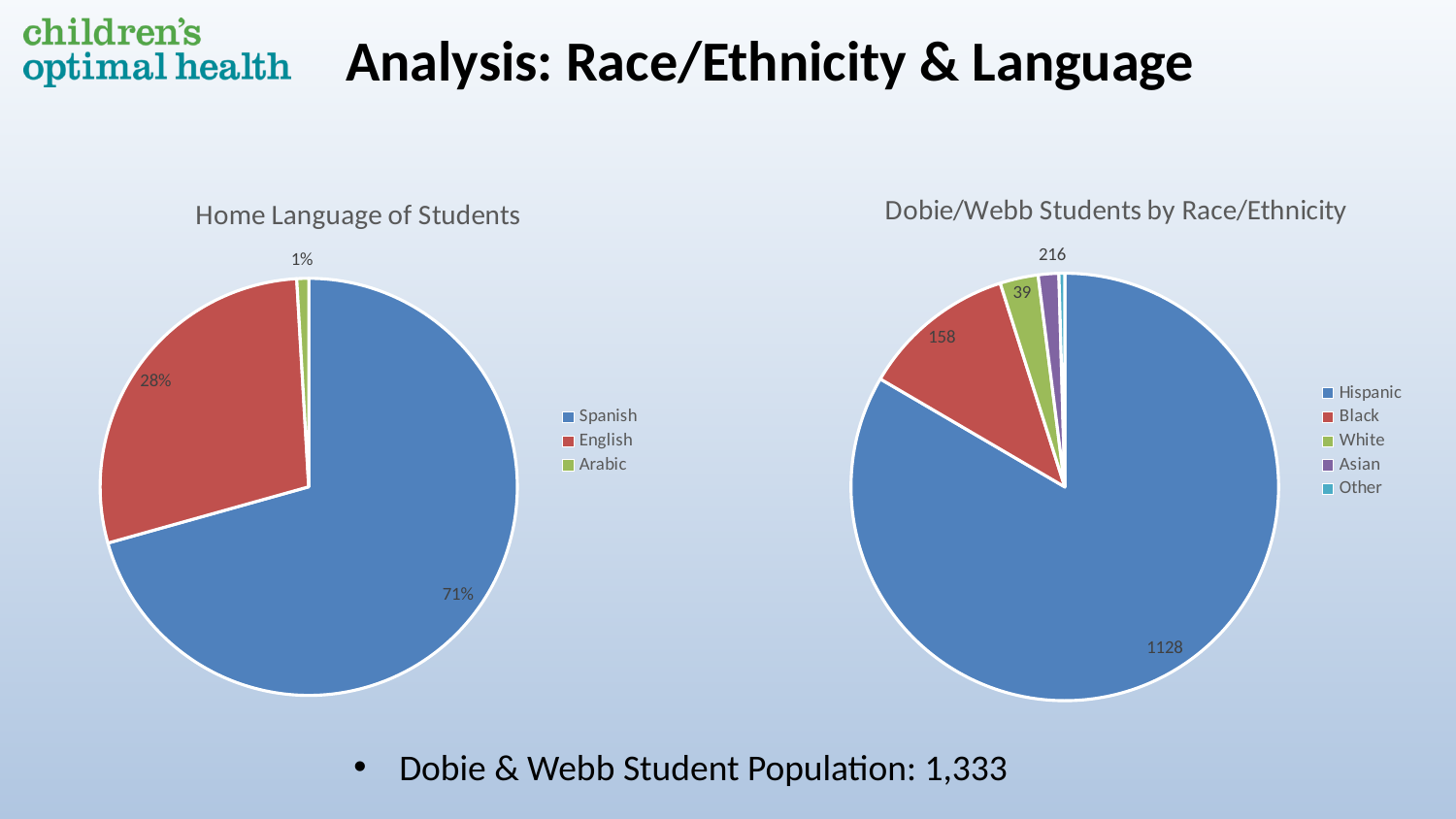
In the "Home Language of Students" chart, what is the value for English? 28% In the "Dobie/Webb Students by Race/Ethnicity" chart, what is the value for Black? 158 In the "Dobie/Webb Students by Race/Ethnicity" chart, what is the value for White? 39 What kind of chart is the "Home Language of Students" chart? Pie chart In the "Dobie/Webb Students by Race/Ethnicity" chart, which category has the largest slice? Hispanic In the "Home Language of Students" chart, what is the value for Arabic? 1% In the "Home Language of Students" chart, how many percentage points larger is Spanish than English? 43 percentage points In the "Dobie/Webb Students by Race/Ethnicity" chart, what is the value for Hispanic? 1128 How many categories does the legend of the "Home Language of Students" chart list? 3 In the "Dobie/Webb Students by Race/Ethnicity" chart, how many more Hispanic students are there than Black students? 970 In the "Home Language of Students" chart, which language has the smallest slice? Arabic In the "Home Language of Students" chart, what share of students speak Spanish at home? 71%